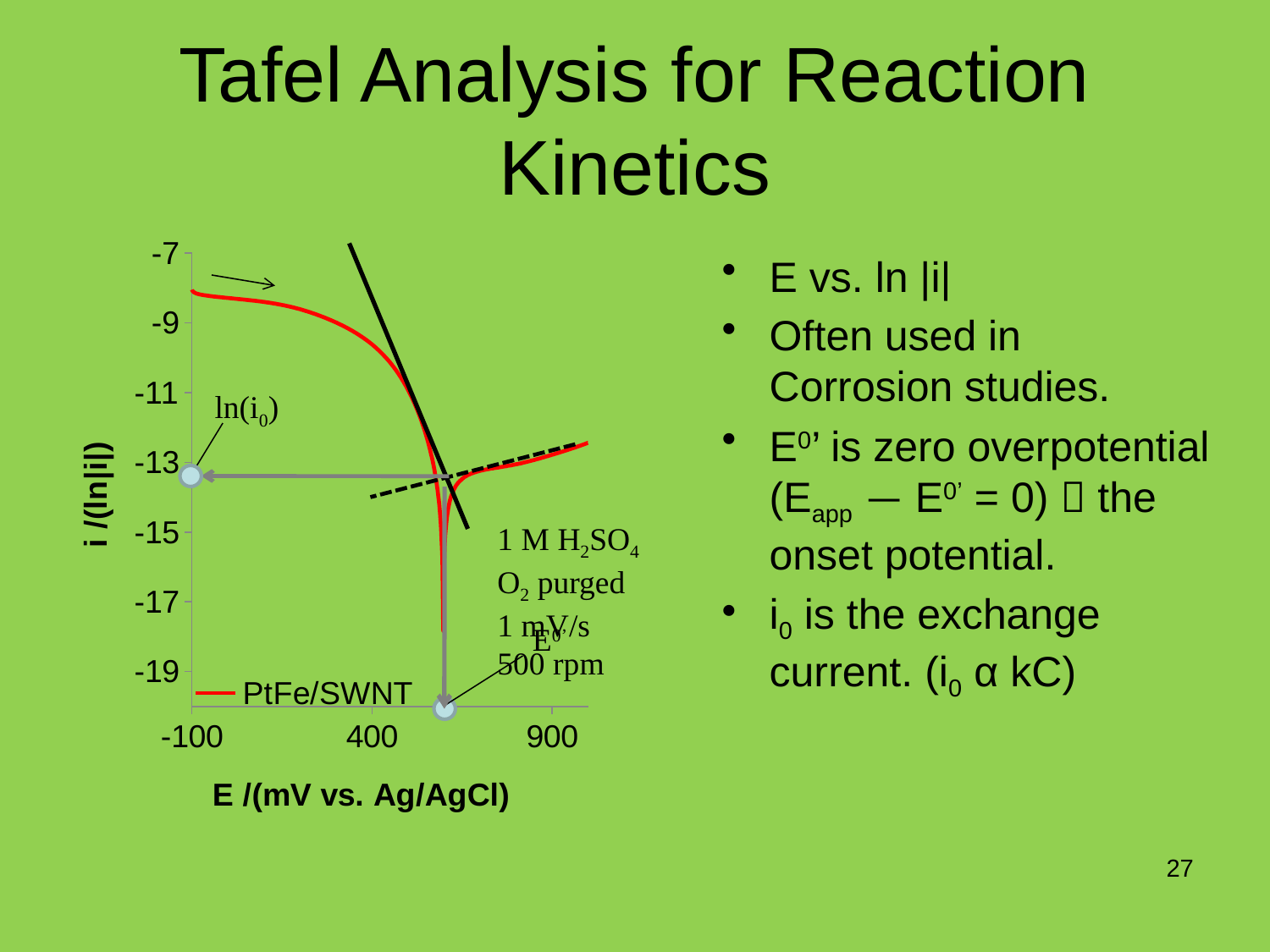
Which is larger: the value of the PtFe/SWNT curve at E = -100 or at E = 400? E = -100 Is the value of the PtFe/SWNT curve at E = 400 greater or less than -11? greater What is the name of the series shown in the chart legend? PtFe/SWNT Is the value of the PtFe/SWNT curve at E = -100 greater or less than -9? greater Between E = -100 and E = 400, does the PtFe/SWNT curve rise or fall? fall How many series does the chart legend list? 1 What is the x-axis title of the chart? E /(mV vs. Ag/AgCl) How many tick labels are shown on the x axis of the chart? 3 What kind of chart is shown on the slide? line chart What is the lowest tick label shown on the y axis of the chart? -19 What is the highest tick label shown on the y axis of the chart? -7 Is the lowest point of the PtFe/SWNT curve greater or less than -17? less